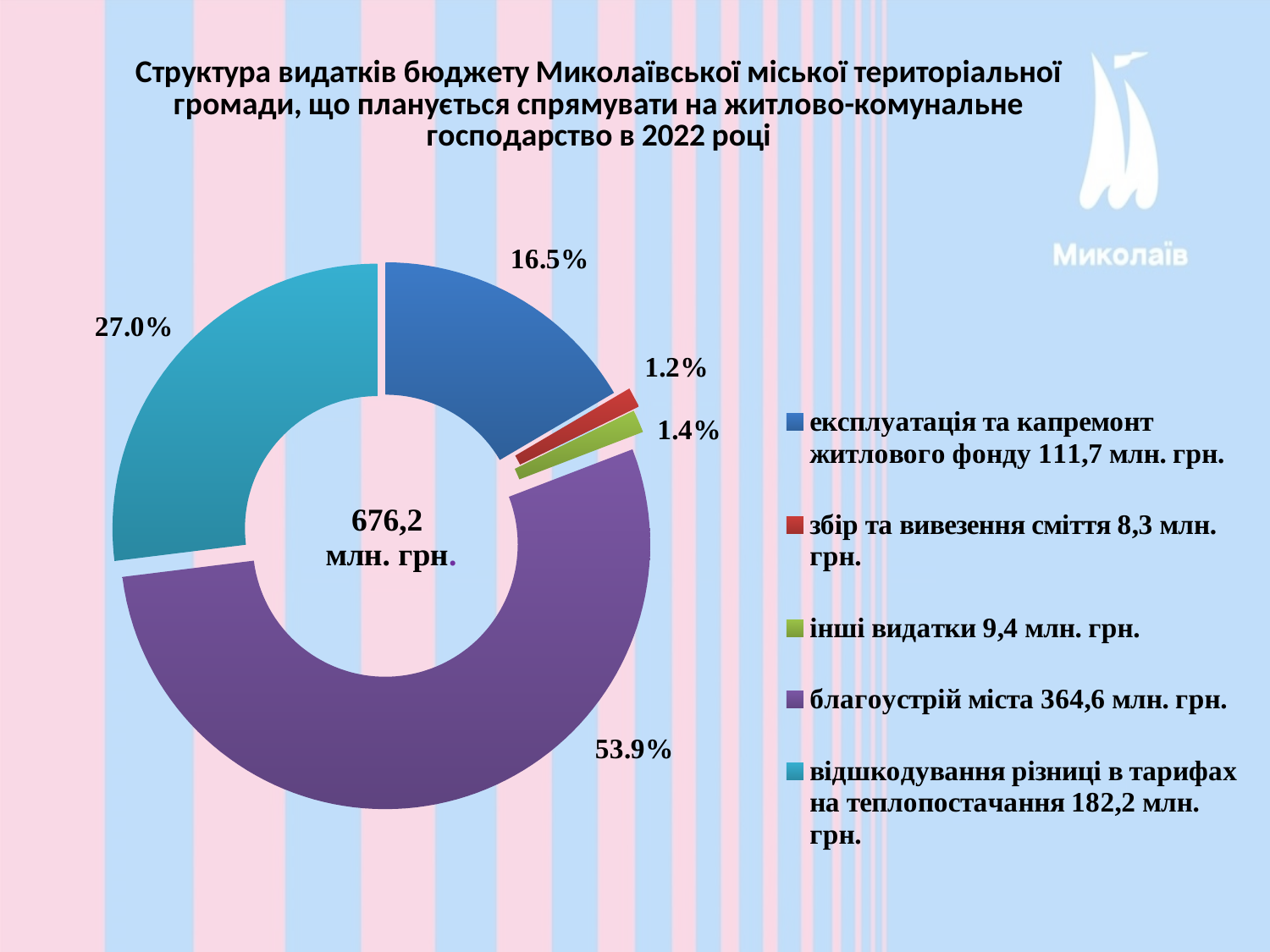
Which category has the smallest slice? збір та вивезення сміття How many slices does the chart have? 5 What percentage is shown for експлуатація та капремонт житлового фонду? 16.5% What percentage is shown for збір та вивезення сміття? 1.2% What share of the chart is labelled for благоустрій міста? 53.9% Which category has the largest slice? благоустрій міста How many entries does the legend list? 5 What kind of chart is shown on the slide? Doughnut (pie) chart What is the difference in percentage points between the благоустрій міста slice and the відшкодування різниці в тарифах на теплопостачання slice? 26.9 percentage points What total amount is printed in the centre of the doughnut? 676,2 млн. грн. According to the legend, what amount is given for інші видатки? 9,4 млн. грн.